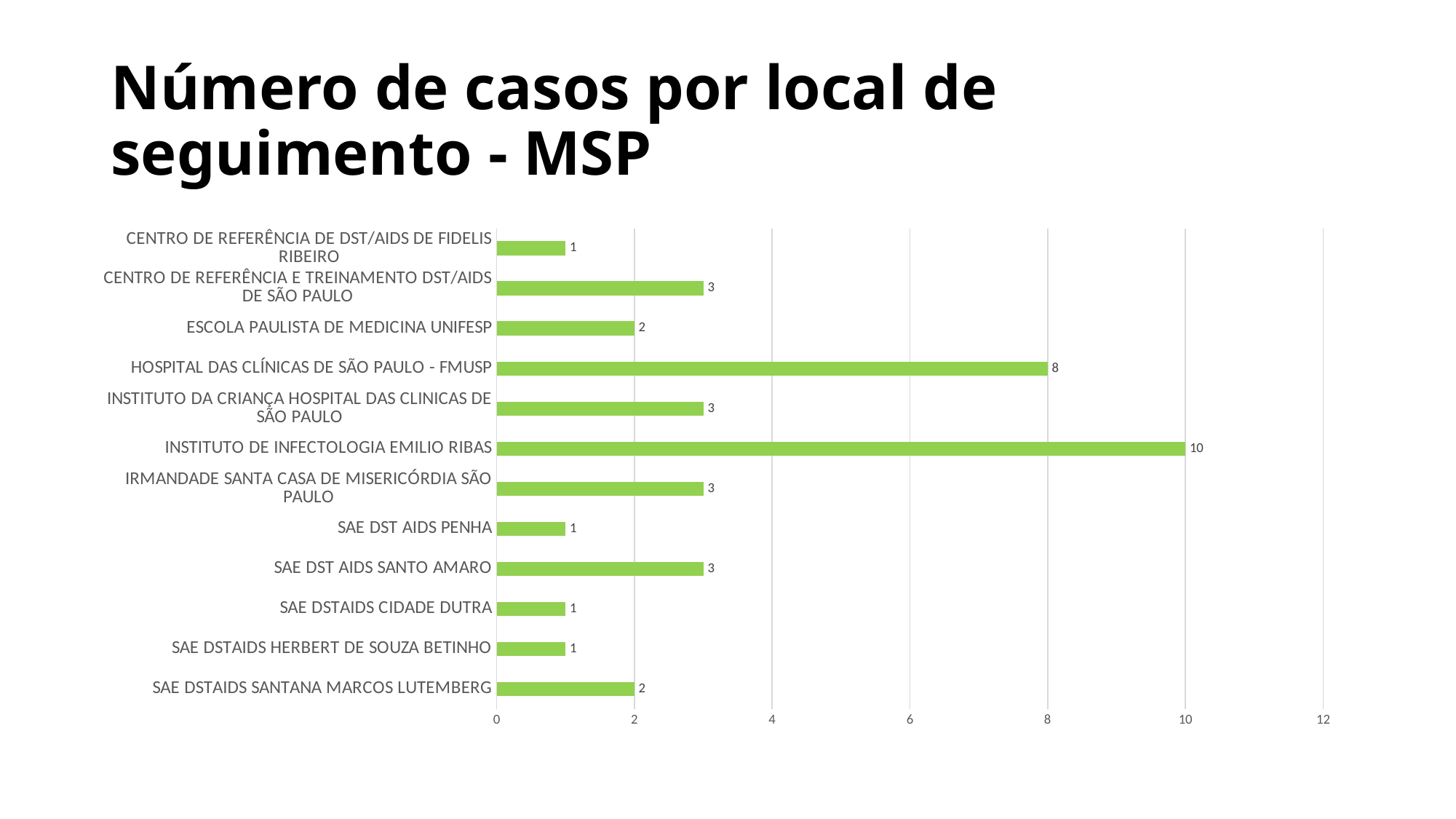
How many locations are shown in the chart? 12 Which location has the highest number of cases? INSTITUTO DE INFECTOLOGIA EMILIO RIBAS What is the number of cases for SAE DST AIDS SANTO AMARO? 3 What is the title of the slide? Número de casos por local de seguimento - MSP What is the number of cases for INSTITUTO DE INFECTOLOGIA EMILIO RIBAS? 10 What is the highest value shown on the x axis? 12 Which has more cases, SAE DST AIDS PENHA or SAE DSTAIDS SANTANA MARCOS LUTEMBERG? SAE DSTAIDS SANTANA MARCOS LUTEMBERG What is the number of cases for ESCOLA PAULISTA DE MEDICINA UNIFESP? 2 What is the number of cases for HOSPITAL DAS CLÍNICAS DE SÃO PAULO - FMUSP? 8 Is the value for HOSPITAL DAS CLÍNICAS DE SÃO PAULO - FMUSP greater or less than 6? greater What is the difference in cases between INSTITUTO DE INFECTOLOGIA EMILIO RIBAS and HOSPITAL DAS CLÍNICAS DE SÃO PAULO - FMUSP? 2 What kind of chart is shown on the slide? bar chart